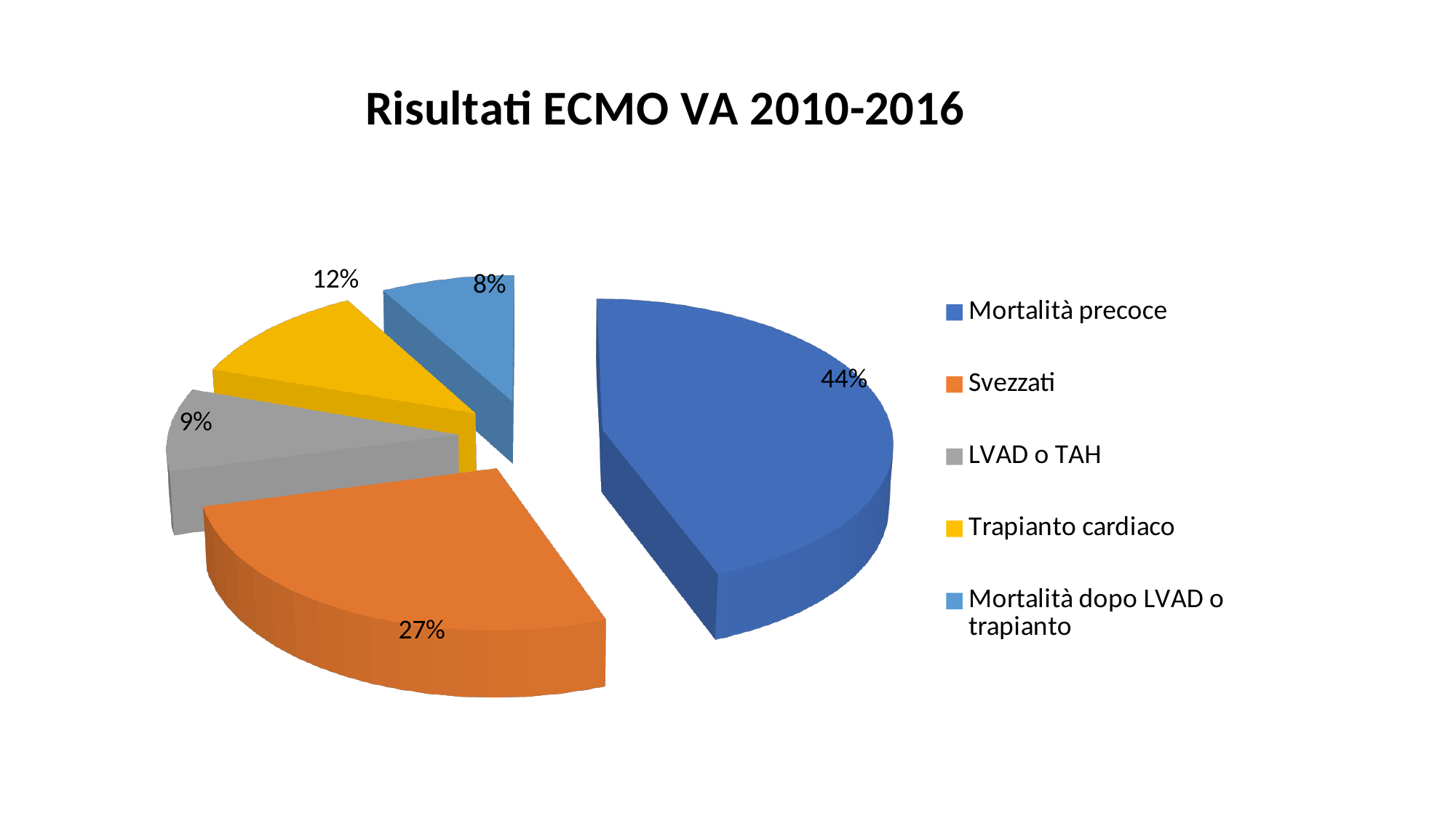
What share of the pie is LVAD o TAH? 9% What share of the pie is Trapianto cardiaco? 12% What is the difference between the shares of Mortalità precoce and Svezzati? 17% What is the title of the chart? Risultati ECMO VA 2010-2016 What share of the pie is Mortalità precoce? 44% How many categories does the pie chart show? 5 Which category has the smallest slice of the pie? Mortalità dopo LVAD o trapianto Which category has the largest slice of the pie? Mortalità precoce What kind of chart is shown on the slide? pie chart Which is larger, the share for Trapianto cardiaco or the share for LVAD o TAH? Trapianto cardiaco